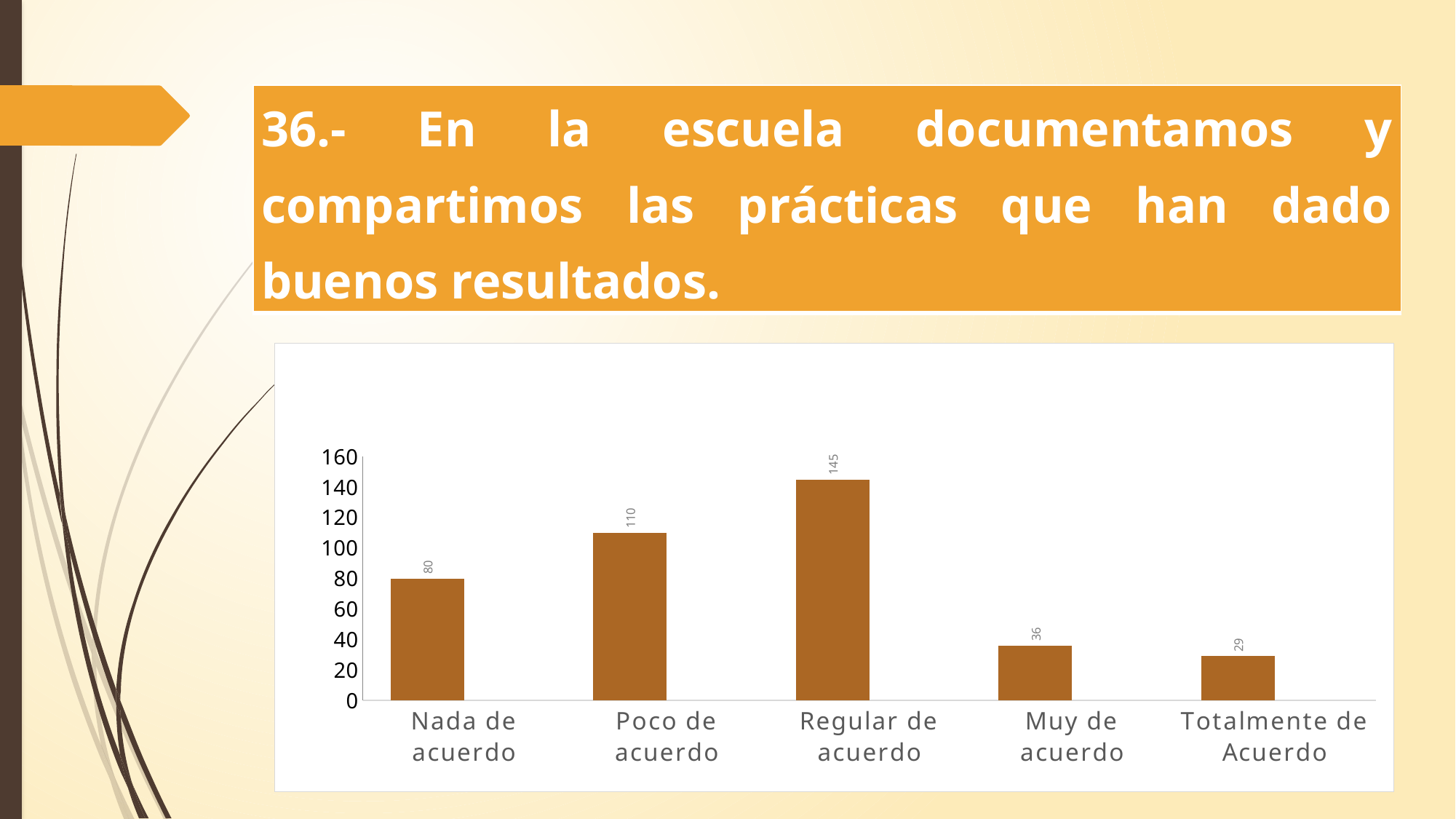
What is the value for "Muy de acuerdo"? 36 What is the value for "Nada de acuerdo"? 80 What kind of chart is shown on the slide? Bar chart Which category has the lowest value? Totalmente de Acuerdo Is the value for "Poco de acuerdo" greater or less than 100? greater What is the highest value shown on the vertical axis? 160 Which category has the highest value? Regular de acuerdo How many categories are shown on the x axis? 5 What is the value for "Regular de acuerdo"? 145 What is the difference between the values for "Regular de acuerdo" and "Poco de acuerdo"? 35 What is the value for "Totalmente de Acuerdo"? 29 Which is larger, the value for "Nada de acuerdo" or the value for "Muy de acuerdo"? Nada de acuerdo